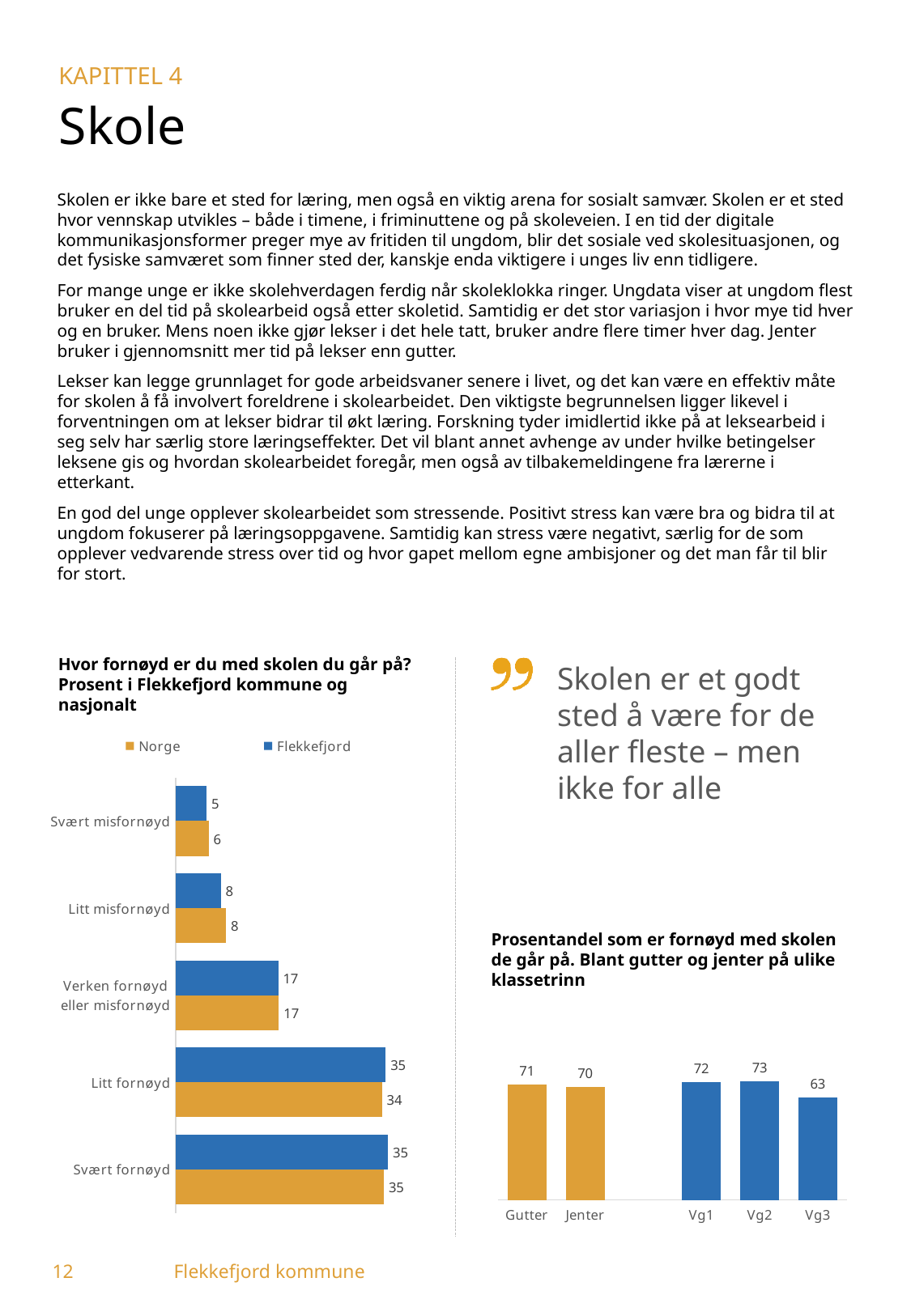
In the chart 'Hvor fornøyd er du med skolen du går på?', what is the difference between the Norge and Flekkefjord values for 'Svært misfornøyd'? 1 In the chart 'Hvor fornøyd er du med skolen du går på?', what is the Flekkefjord value for 'Svært misfornøyd'? 5 In the chart 'Hvor fornøyd er du med skolen du går på?', which category has the lowest Flekkefjord value? Svært misfornøyd In the chart 'Prosentandel som er fornøyd med skolen de går på', what is the value for Vg2? 73 What kind of chart is 'Hvor fornøyd er du med skolen du går på?'? Bar chart In the chart 'Hvor fornøyd er du med skolen du går på?', what is the Norge value for 'Verken fornøyd eller misfornøyd'? 17 In the chart 'Prosentandel som er fornøyd med skolen de går på', which category has the lowest value? Vg3 In the chart 'Prosentandel som er fornøyd med skolen de går på', what is the difference between Vg2 and Vg3? 10 In the chart 'Hvor fornøyd er du med skolen du går på?', how many series does the legend list? 2 In the chart 'Prosentandel som er fornøyd med skolen de går på', which is larger, Gutter or Jenter? Gutter In the chart 'Hvor fornøyd er du med skolen du går på?', what is the Norge value for 'Litt fornøyd'? 34 In the chart 'Hvor fornøyd er du med skolen du går på?', how many categories are shown? 5